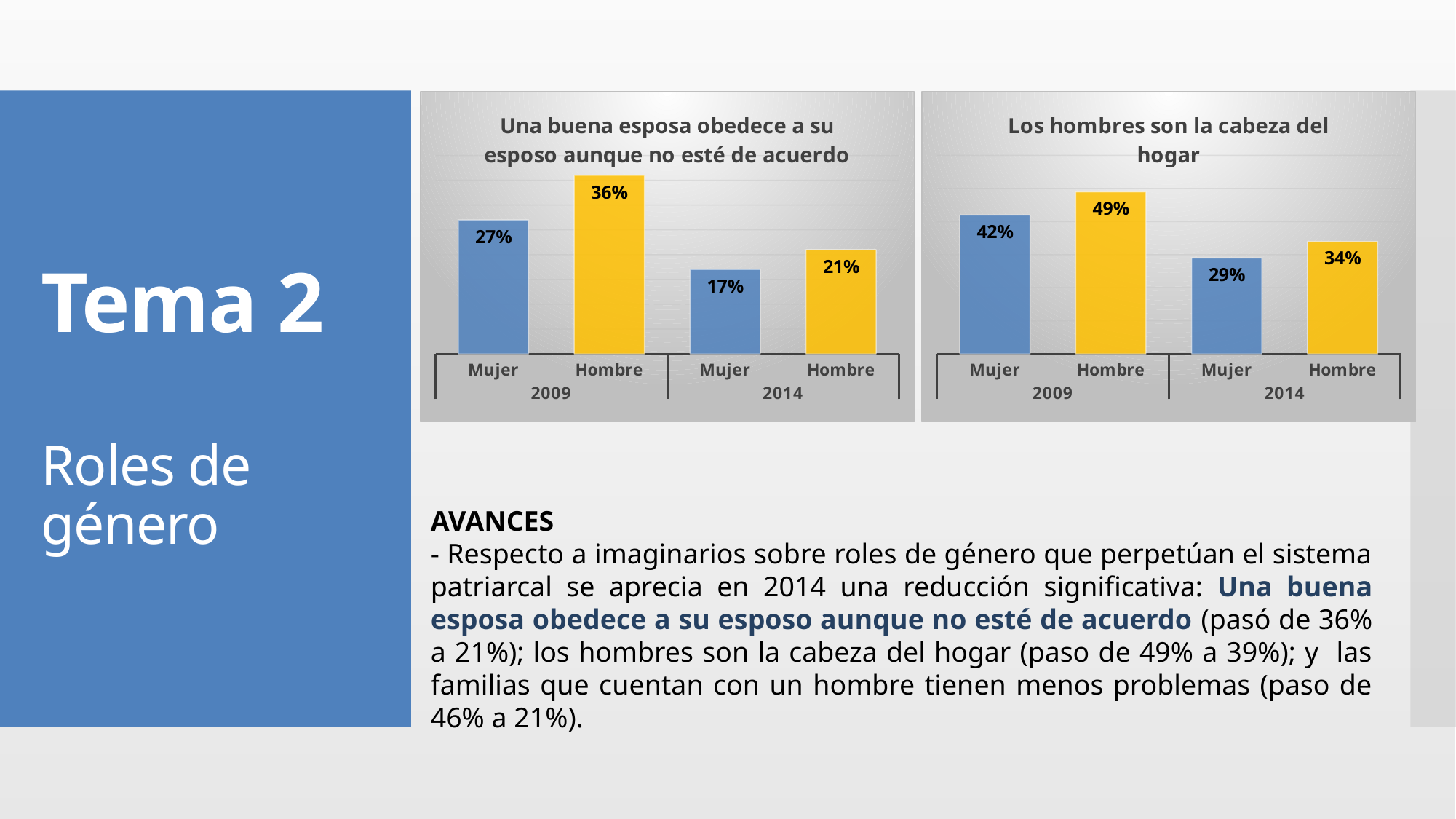
In the chart titled 'Los hombres son la cabeza del hogar', what is the difference between the Mujer values for 2009 and 2014? 13% In the chart titled 'Los hombres son la cabeza del hogar', what is the value for Hombre in 2009? 49% What kind of chart is the chart titled 'Los hombres son la cabeza del hogar'? Bar chart In the chart titled 'Los hombres son la cabeza del hogar', what colour are the Hombre bars? Yellow In the chart titled 'Los hombres son la cabeza del hogar', what is the value for Mujer in 2014? 29% In the chart titled 'Una buena esposa obedece a su esposo aunque no esté de acuerdo', which bar has the highest value? Hombre 2009 In the chart titled 'Una buena esposa obedece a su esposo aunque no esté de acuerdo', what is the value for Hombre in 2009? 36% In the chart titled 'Una buena esposa obedece a su esposo aunque no esté de acuerdo', what is the difference between the Hombre values for 2009 and 2014? 15% In the chart titled 'Los hombres son la cabeza del hogar', which is larger: Mujer 2009 or Hombre 2014? Mujer 2009 In the chart titled 'Los hombres son la cabeza del hogar', which bar has the lowest value? Mujer 2014 In the chart titled 'Una buena esposa obedece a su esposo aunque no esté de acuerdo', what is the value for Mujer in 2014? 17% How many bars are plotted in the chart titled 'Una buena esposa obedece a su esposo aunque no esté de acuerdo'? 4